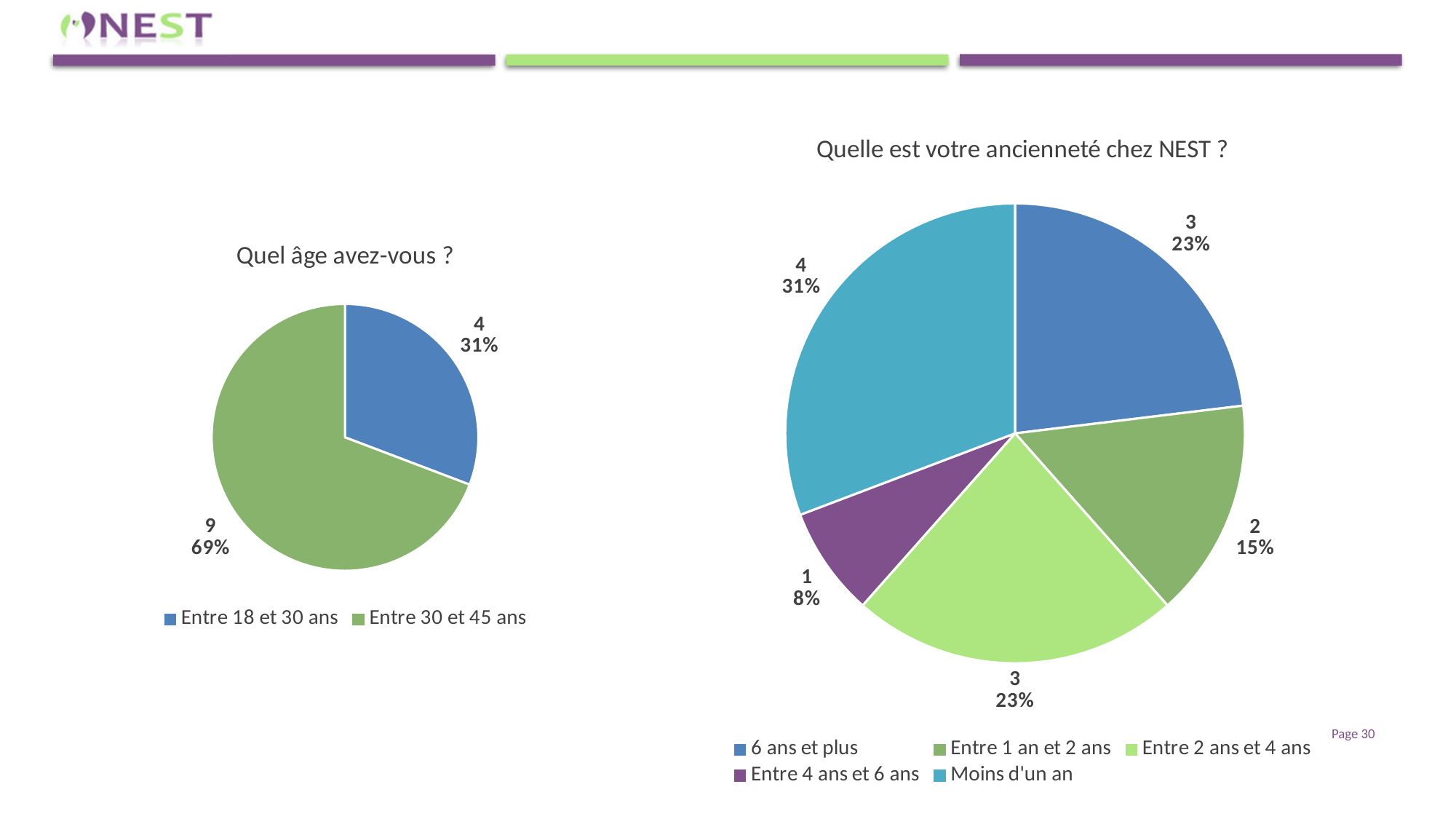
In the chart titled "Quel âge avez-vous ?", what is the difference in count between "Entre 30 et 45 ans" and "Entre 18 et 30 ans"? 5 In the chart titled "Quelle est votre ancienneté chez NEST ?", which category has the smallest slice? Entre 4 ans et 6 ans In the chart titled "Quel âge avez-vous ?", how many respondents are in the "Entre 30 et 45 ans" category? 9 In the chart titled "Quelle est votre ancienneté chez NEST ?", what share of the pie does "Entre 4 ans et 6 ans" represent? 8% What kind of chart is the one titled "Quel âge avez-vous ?"? Pie chart In the chart titled "Quelle est votre ancienneté chez NEST ?", what is the difference in count between "Moins d'un an" and "Entre 1 an et 2 ans"? 2 In the chart titled "Quelle est votre ancienneté chez NEST ?", which category has the largest slice? Moins d'un an How many categories does the legend of the chart titled "Quelle est votre ancienneté chez NEST ?" list? 5 In the chart titled "Quelle est votre ancienneté chez NEST ?", which is larger: "Entre 1 an et 2 ans" or "Moins d'un an"? Moins d'un an In the chart titled "Quel âge avez-vous ?", what share of the pie does "Entre 18 et 30 ans" represent? 31% How many categories does the legend of the chart titled "Quel âge avez-vous ?" list? 2 In the chart titled "Quelle est votre ancienneté chez NEST ?", how many respondents are in the "Moins d'un an" category? 4